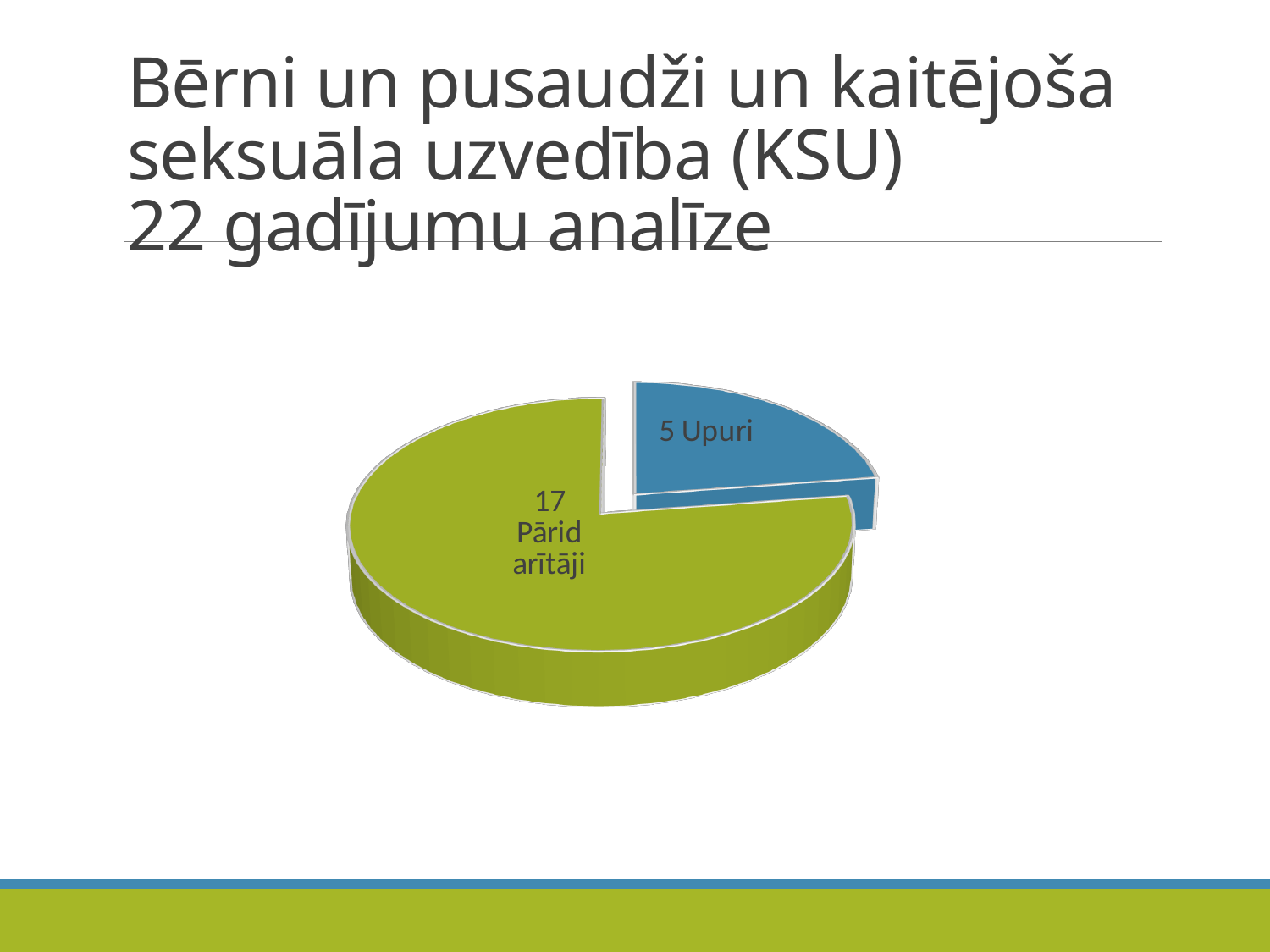
What is the total of the two values shown in the pie chart? 22 What is the value for Upuri in the pie chart? 5 What is the value for Pāridarītāji in the pie chart? 17 Which is larger, the value for Upuri or the value for Pāridarītāji? Pāridarītāji Which category has the smallest slice in the pie chart? Upuri What colour is the Upuri slice in the pie chart? Blue Which category has the largest slice in the pie chart? Pāridarītāji What kind of chart is shown on the slide? Pie chart What share of the pie does Pāridarītāji represent? 77% What colour is the Pāridarītāji slice in the pie chart? Green How many slices does the pie chart have? 2 What is the difference between the values for Pāridarītāji and Upuri? 12